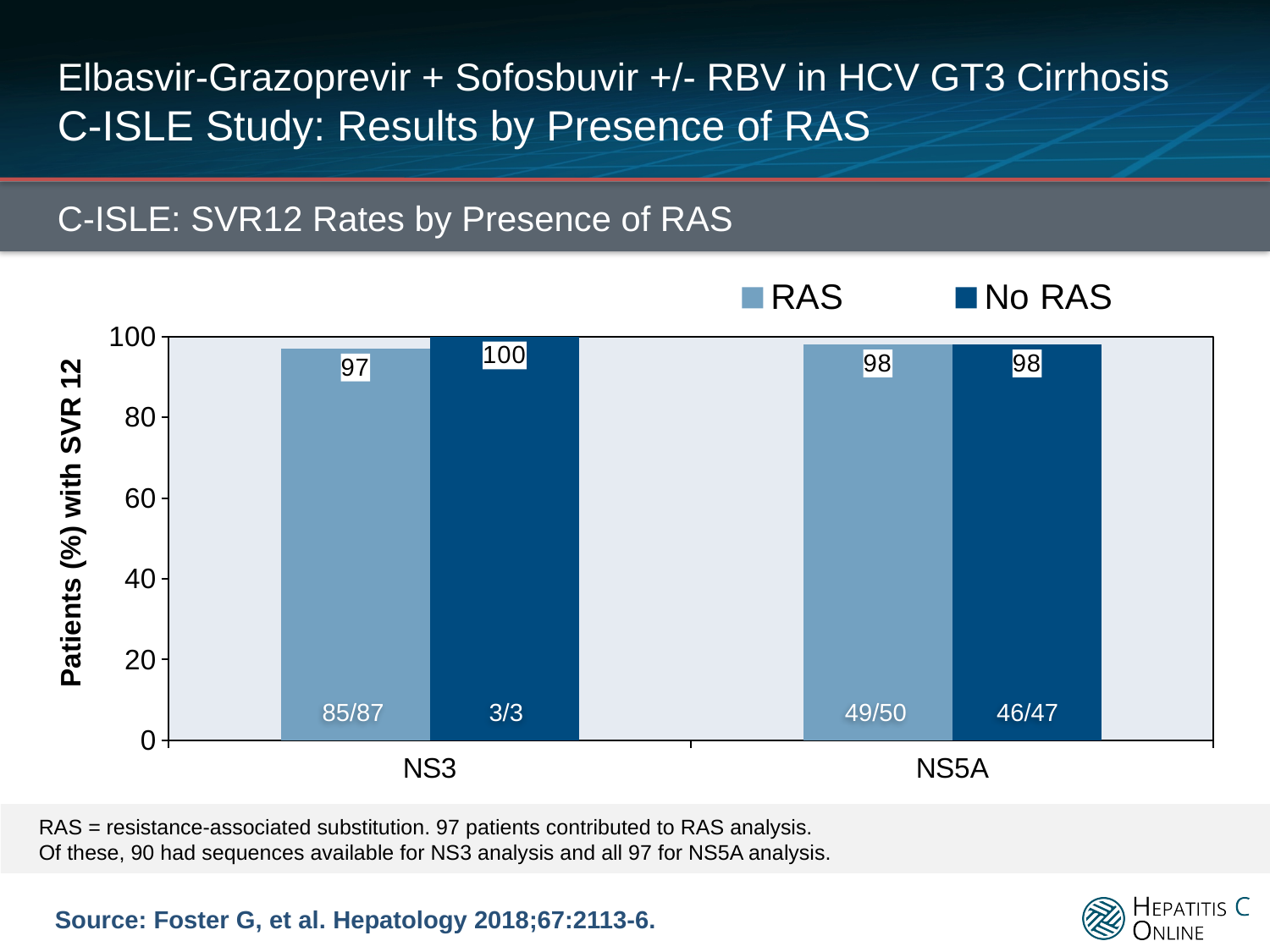
What is the difference between the No RAS and RAS SVR12 rates in the NS3 group? 3 How many series does the legend list? 2 How many patients achieved SVR12 out of the total in the NS5A No RAS group, as labeled on the bar? 46/47 What is the SVR12 rate for patients with No RAS in the NS5A group? 98 What is the SVR12 rate for patients with No RAS in the NS3 group? 100 Which bar shows the lowest SVR12 rate? RAS, NS3 How many patients achieved SVR12 out of the total in the NS3 RAS group, as labeled on the bar? 85/87 Which bar shows the highest SVR12 rate? No RAS, NS3 What is the label of the y-axis? Patients (%) with SVR 12 What is the SVR12 rate for patients with RAS in the NS5A group? 98 What type of chart is shown on the slide? Bar chart What is the SVR12 rate for patients with RAS in the NS3 group? 97